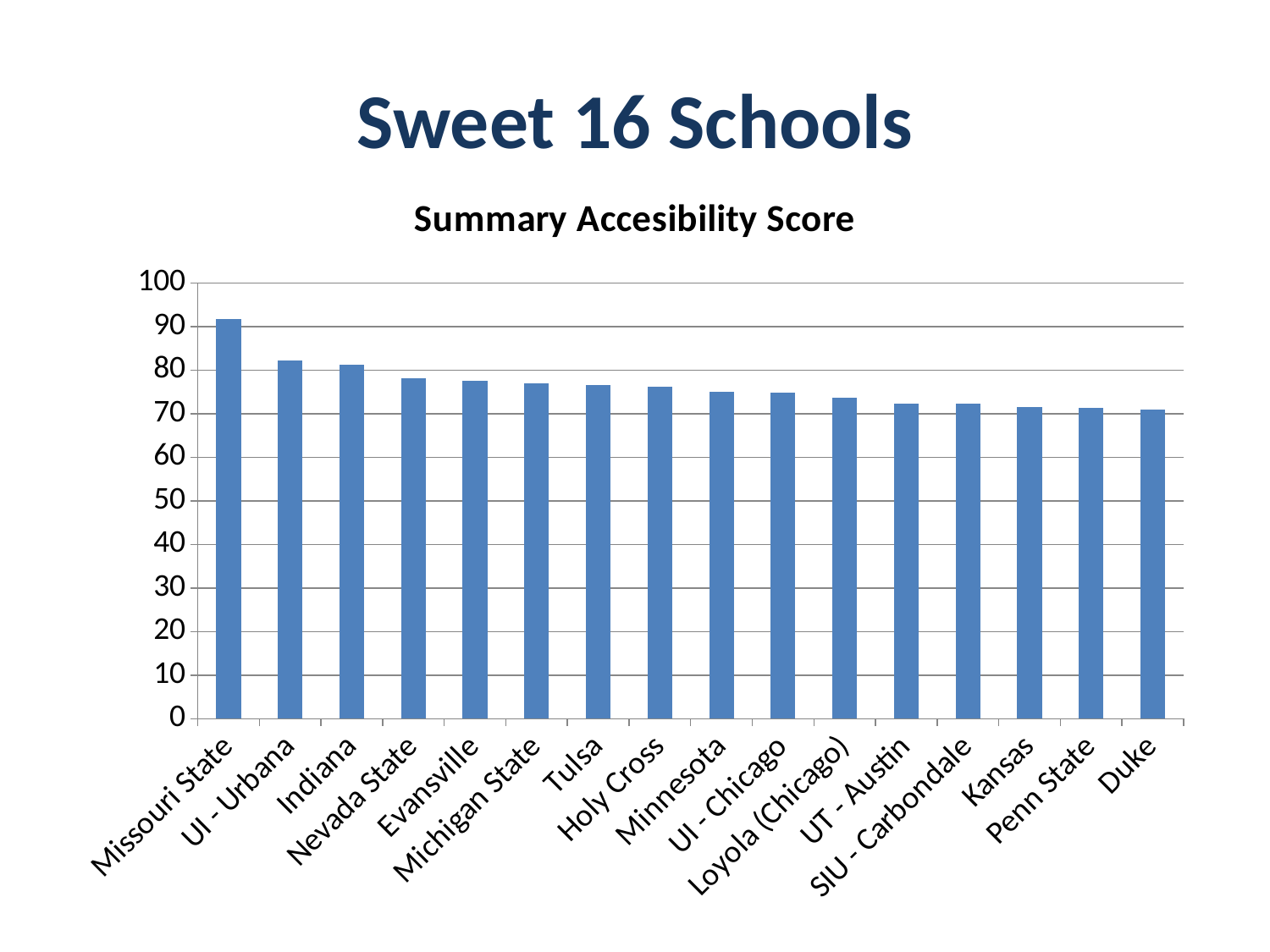
Is the value for Nevada State greater or less than 80? less What is the title of the chart? Summary Accesibility Score What kind of chart is shown on the slide? Bar chart Is the value for UI - Urbana greater or less than 80? greater Which school has the highest Summary Accessibility Score? Missouri State Is the value for Missouri State greater or less than 90? greater Do the scores rise or fall moving from left to right along the x axis? Fall Which has a higher score, Indiana or Minnesota? Indiana Which has a higher score, Duke or Missouri State? Missouri State How many schools are shown on the chart? 16